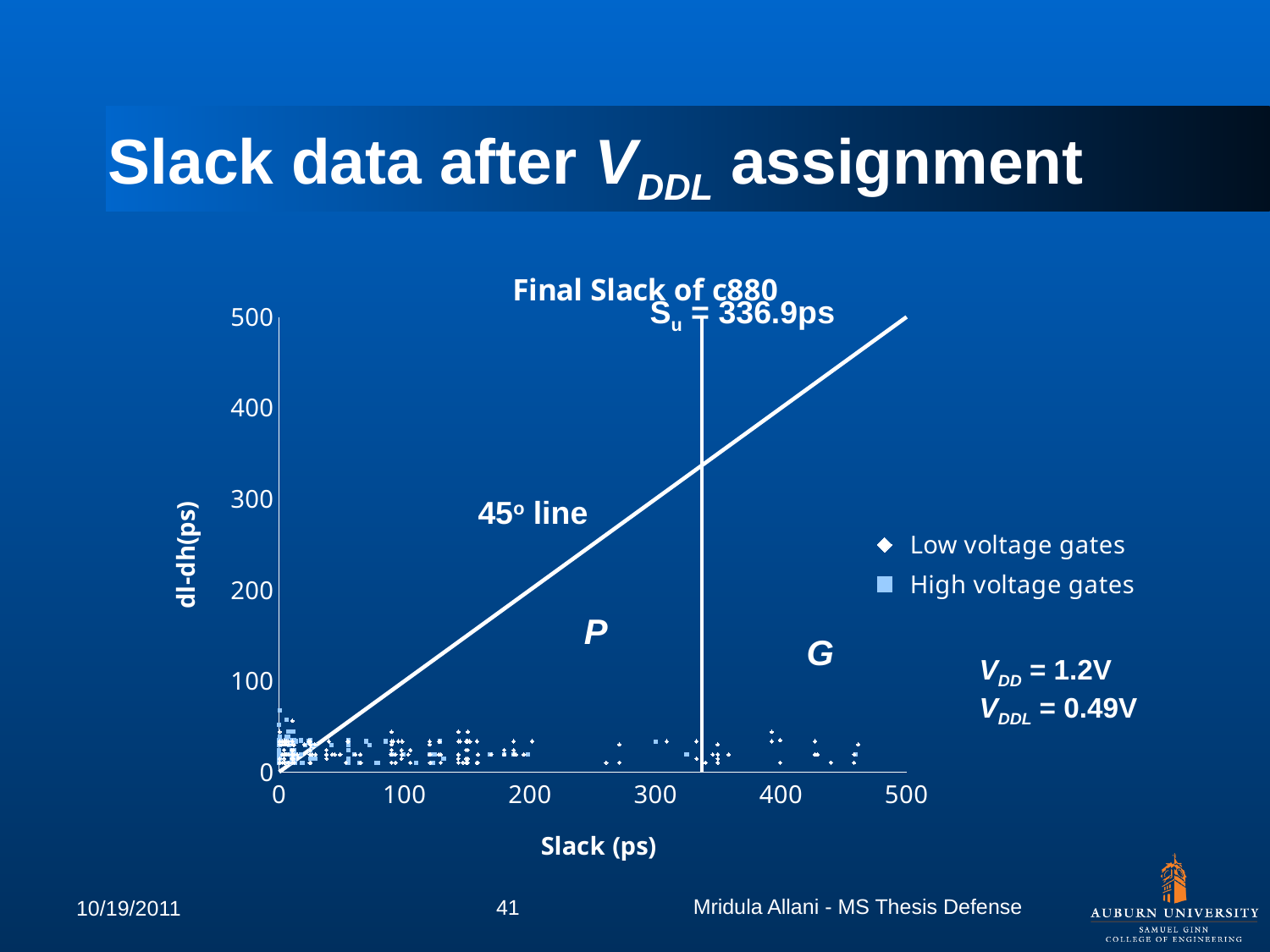
Are the dl-dh values of the plotted gates greater or less than 100? less What kind of chart is shown on the slide? scatter chart What is the label of the y axis? dl-dh(ps) What value of Su is annotated on the chart? 336.9ps What is the maximum value shown on the y axis? 500 How many series does the legend list? 2 What are the two series named in the legend? Low voltage gates, High voltage gates What VDD value is stated on the slide? 1.2V What is the label of the x axis? Slack (ps) What VDDL value is stated on the slide? 0.49V What is the title of the chart? Final Slack of c880 What is the maximum value shown on the x axis? 500